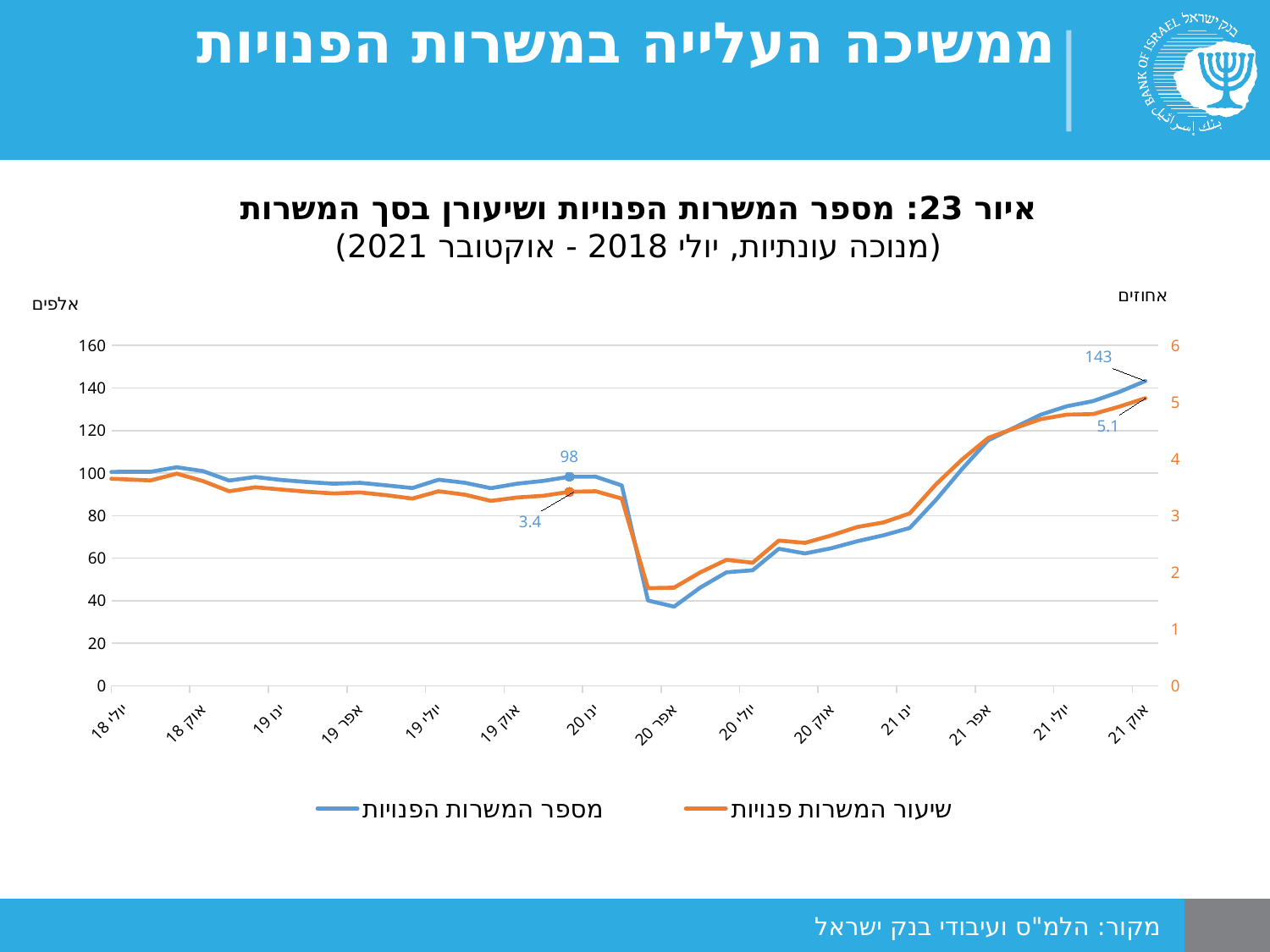
Which labelled value of the number of vacant jobs is larger: the one around January 2020 or the one in October 2021? October 2021 (143) How many series does the legend list? 2 Is the number of vacant jobs (blue line) around April 2020 greater or less than 60 thousand? less By how much did the labelled number of vacant jobs rise from the 98 point (around January 2020) to the 143 point (October 2021)? 45 Is the number of vacant jobs (blue line) in July 2018 greater or less than 80 thousand? greater What is the labelled value of the number of vacant jobs (מספר המשרות הפנויות) at the end of the series, in October 2021? 143 What is the labelled value of the vacancy rate (שיעור המשרות פנויות) at the end of the series, in October 2021? 5.1 What is the labelled value of the vacancy rate (שיעור המשרות פנויות) at the point marked around January 2020? 3.4 What is the difference between the labelled vacancy rate values 5.1 and 3.4? 1.7 What unit is shown on the left vertical axis of the chart? אלפים What kind of chart is shown on the slide? Line chart What is the labelled value of the number of vacant jobs (מספר המשרות הפנויות) at the point marked around January 2020? 98